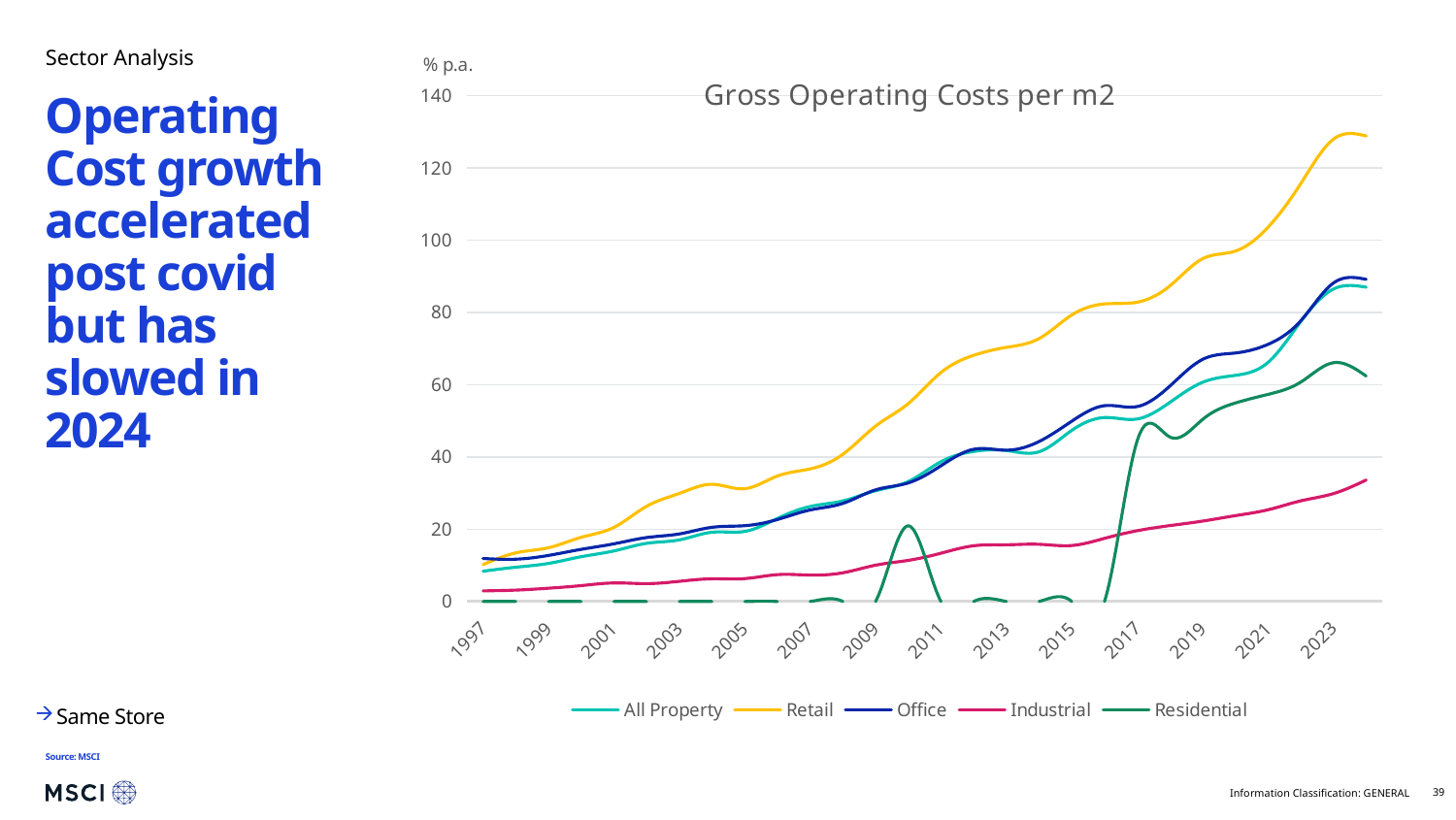
Is the value for Office at the right end of the chart greater or less than 80? greater What kind of chart is shown on the slide? line chart Which series is plotted with the yellow line? Retail Does the Retail line generally rise or fall from 1997 to 2023? rise Which is larger at the right end of the chart, Office or Residential? Office Which series has the highest value at the right end of the chart (2023)? Retail What is the title of the chart? Gross Operating Costs per m2 How many year labels are shown on the x axis? 14 Is the value for Retail at the right end of the chart greater or less than 120? greater Is the value for Industrial at the right end of the chart greater or less than 40? less How many series does the legend of the chart list? 5 Which series has the lowest value at the right end of the chart (2023)? Industrial